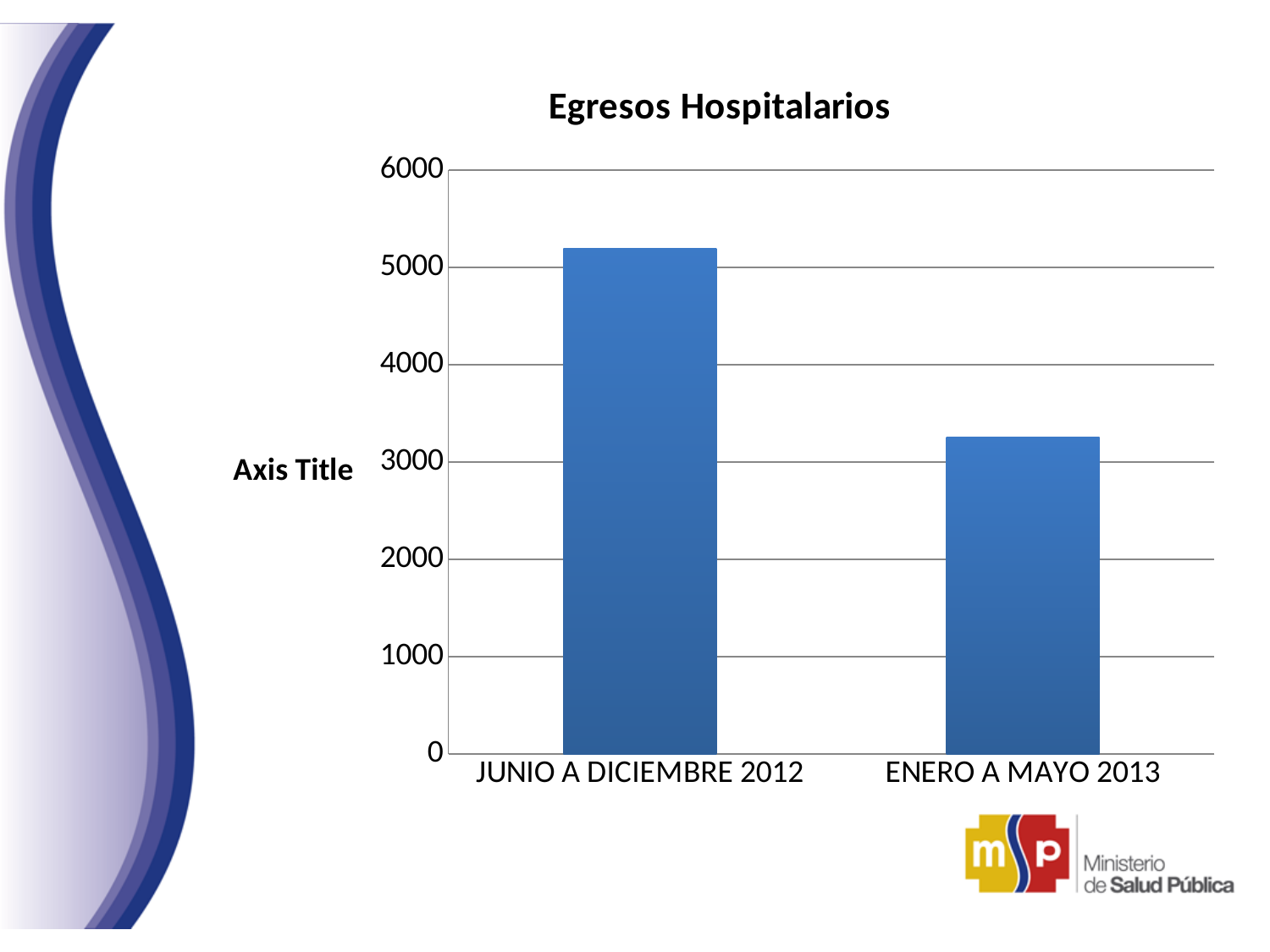
Is the value for ENERO A MAYO 2013 greater or less than 3000? greater Which category has the lowest value in the chart? ENERO A MAYO 2013 What kind of chart is shown on the slide? bar chart What is the title of the chart? Egresos Hospitalarios Do the values rise or fall from JUNIO A DICIEMBRE 2012 to ENERO A MAYO 2013? fall What is the label shown on the vertical axis of the chart? Axis Title Is the value for JUNIO A DICIEMBRE 2012 greater or less than 5000? greater Which is larger, the value for JUNIO A DICIEMBRE 2012 or the value for ENERO A MAYO 2013? JUNIO A DICIEMBRE 2012 Which category has the highest value in the chart? JUNIO A DICIEMBRE 2012 Is the value for JUNIO A DICIEMBRE 2012 greater or less than 6000? less How many categories are shown on the x axis of the chart? 2